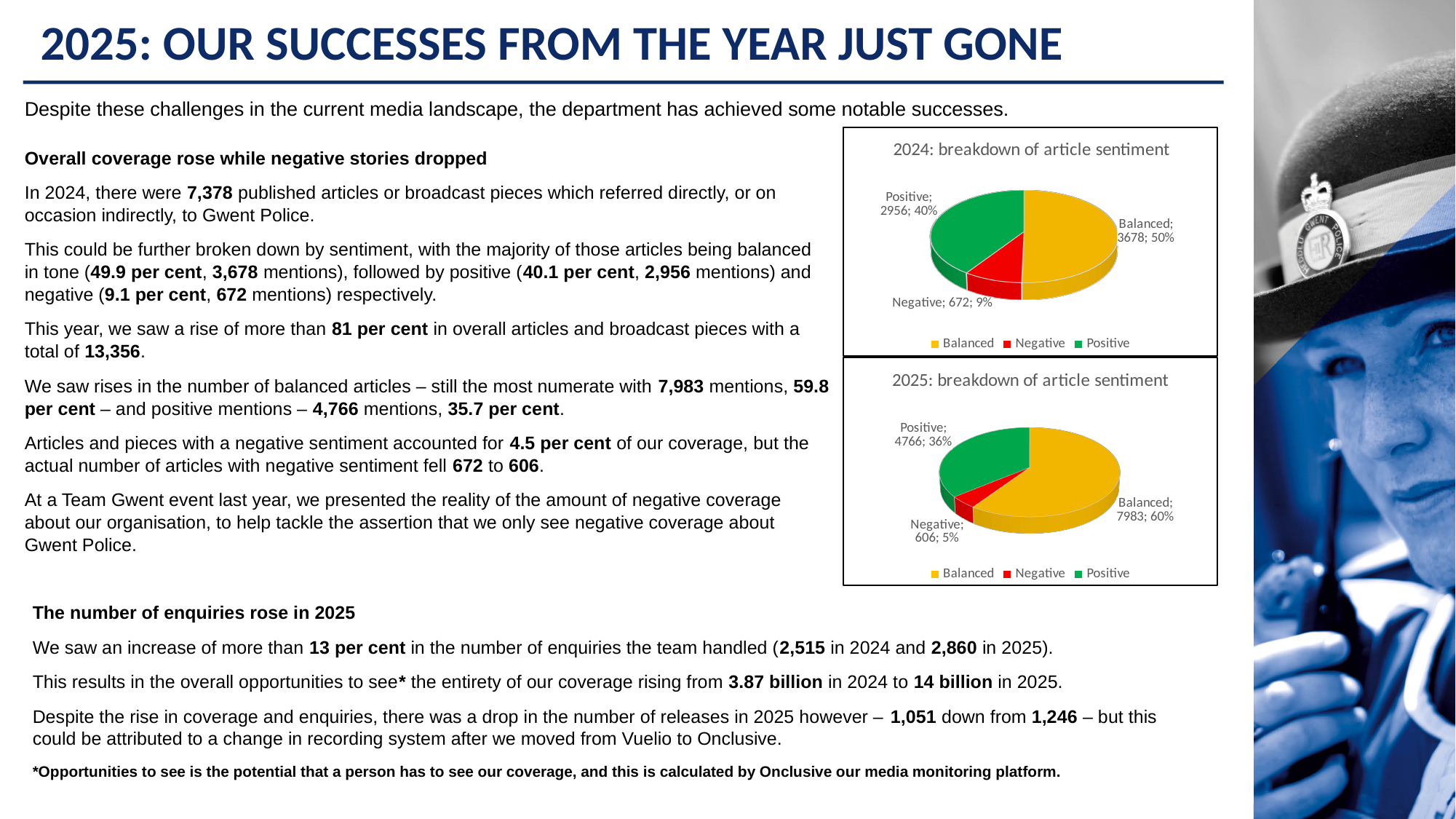
How many categories does the '2025: breakdown of article sentiment' chart show? 3 In the '2024: breakdown of article sentiment' chart, what is the value for Balanced? 3678 In the '2024: breakdown of article sentiment' chart, what share of the pie does Positive represent? 40% In the '2025: breakdown of article sentiment' chart, what is the value for Negative? 606 In the '2024: breakdown of article sentiment' chart, what is the value for Negative? 672 In the '2025: breakdown of article sentiment' chart, which is larger, Positive or Negative? Positive In the '2024: breakdown of article sentiment' chart, which category has the smallest slice? Negative In the '2024: breakdown of article sentiment' chart, what is the difference between the Balanced and Positive values? 722 In the '2025: breakdown of article sentiment' chart, what is the value for Positive? 4766 In the '2025: breakdown of article sentiment' chart, which category has the largest slice? Balanced In the '2025: breakdown of article sentiment' chart, what share of the pie does Balanced represent? 60% What kind of chart is the '2024: breakdown of article sentiment' chart? Pie chart